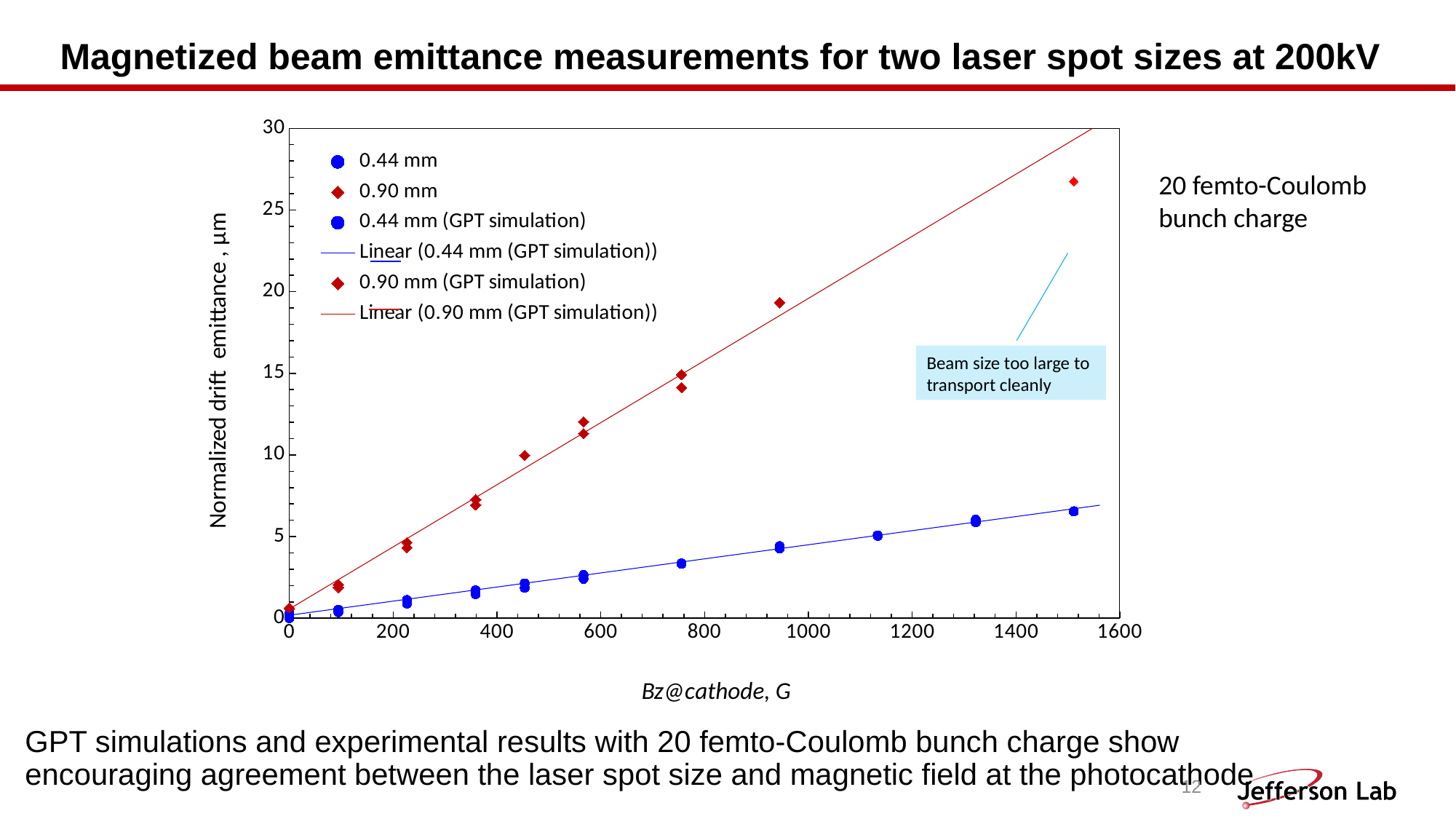
What colour are the markers for the 0.90 mm series? red Is the 0.90 mm emittance value at about 950 G greater or less than 15? greater How many entries does the chart legend list? 6 Which laser spot size series reaches the higher normalized drift emittance, 0.44 mm or 0.90 mm? 0.90 mm Is the 0.44 mm emittance value at about 750 G greater or less than 5? less Is the 0.90 mm emittance value at about 1500 G greater or less than 25? greater What is the title of the x axis of the chart? Bz@cathode, G At about 950 G, which series has the larger emittance, 0.44 mm or 0.90 mm? 0.90 mm Do the 0.90 mm values rise or fall as Bz@cathode increases? rise Do the 0.44 mm values rise or fall as Bz@cathode increases? rise What kind of chart is shown on the slide? scatter chart